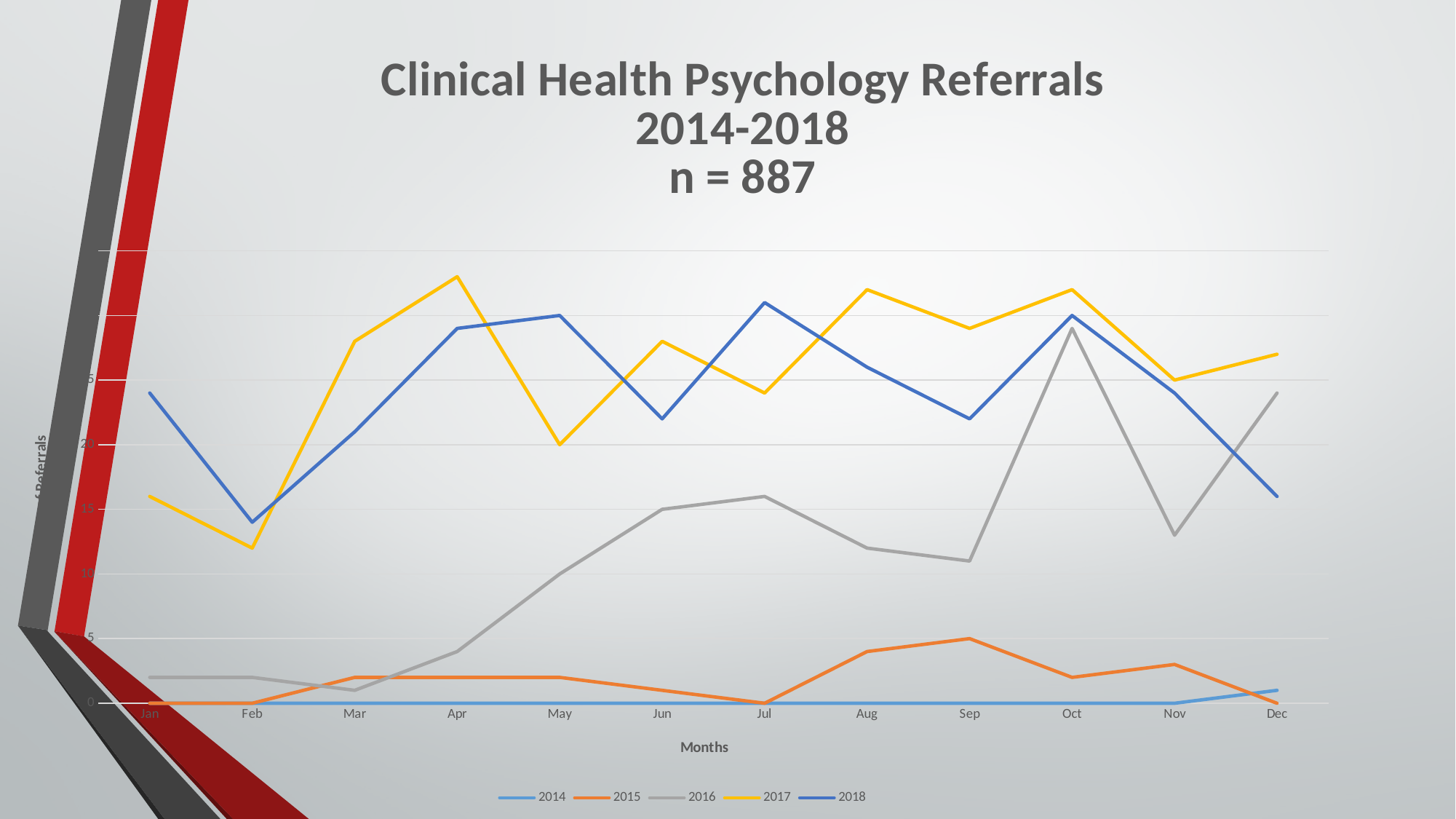
Is the value for 2016 in Jan greater or less than 5? less In which month does the 2017 series have its lowest value? Feb What is the title of the chart? Clinical Health Psychology Referrals 2014-2018 n = 887 In Dec, which series has the larger value, 2016 or 2018? 2016 How many months are plotted along the x axis? 12 What is the label of the x axis? Months What is the value for 2015 in Jul? 0 In which month does the 2016 series reach its highest value? Oct Is the value for 2017 in Apr greater or less than 25? greater What kind of chart is shown on the slide? line chart How many series does the legend list? 5 Is the value for 2016 in Oct greater or less than 25? greater